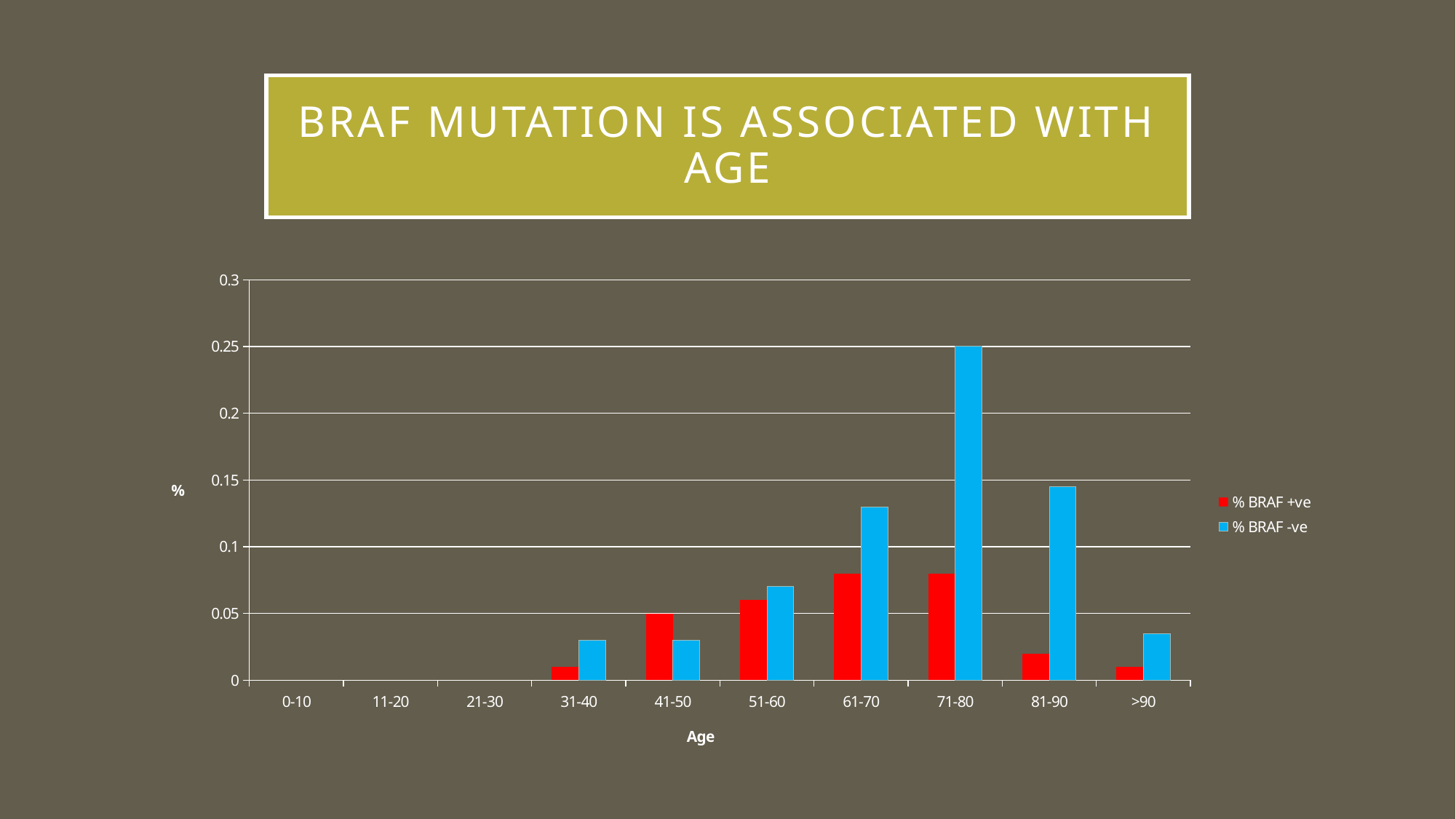
How many age categories are shown on the x axis? 10 Is the value for % BRAF -ve in the 61-70 age group greater or less than 0.1? greater Which age group has the highest value for % BRAF -ve? 71-80 What kind of chart is shown on the slide? bar chart What is the value for % BRAF -ve in the 71-80 age group? 0.25 Which is larger in the 41-50 age group, % BRAF +ve or % BRAF -ve? % BRAF +ve Is the value for % BRAF +ve in the 61-70 age group greater or less than 0.1? less What is the title of the chart on the slide? BRAF MUTATION IS ASSOCIATED WITH AGE What colour are the bars for % BRAF -ve? blue Is the value for % BRAF -ve in the 81-90 age group greater or less than 0.1? greater Which is larger in the 71-80 age group, % BRAF +ve or % BRAF -ve? % BRAF -ve How many series does the legend list? 2